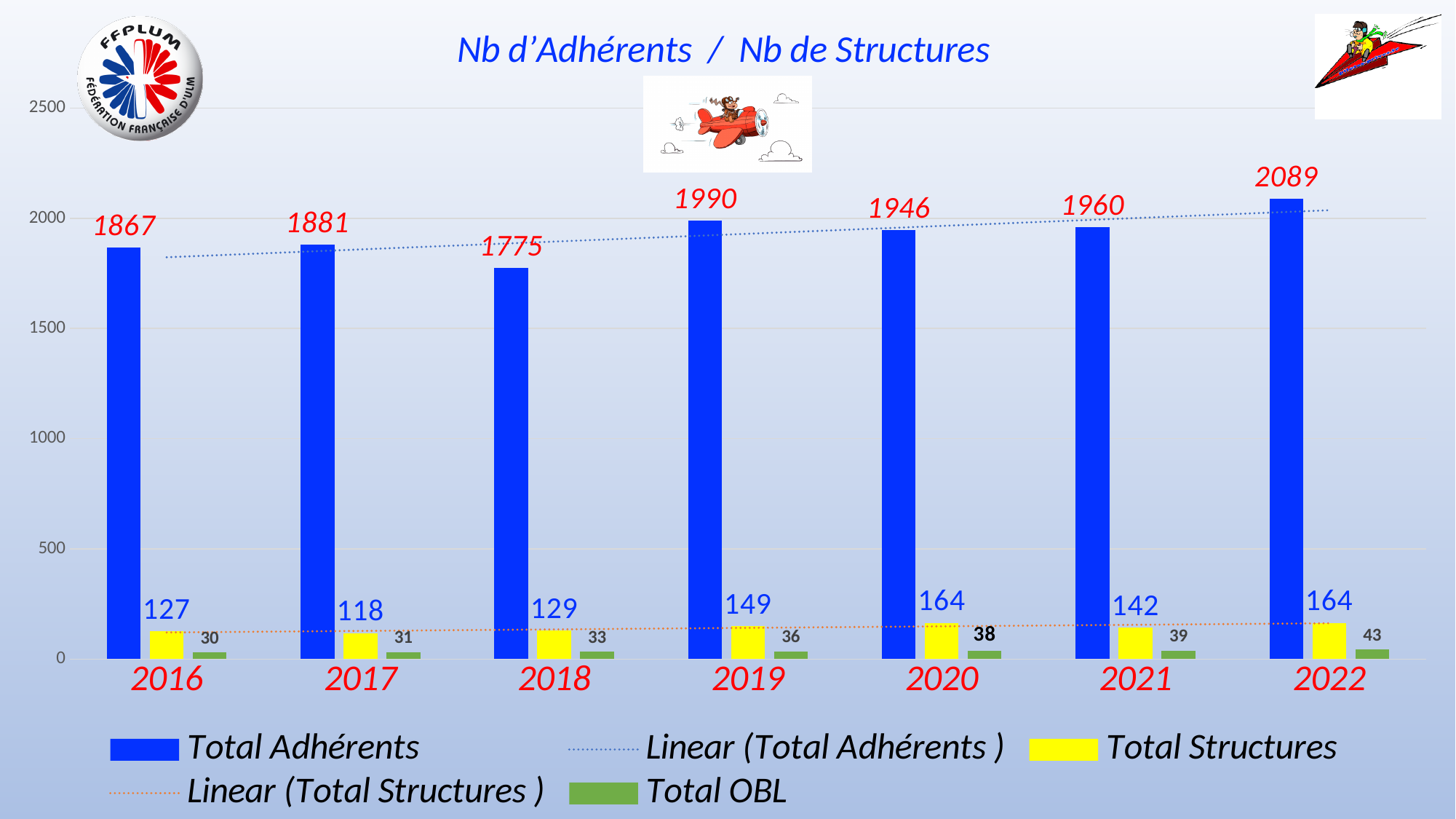
Do the Total OBL values rise or fall from 2016 to 2022? rise What is the difference between the Total Adhérents values for 2022 and 2016? 222 Which year has the lowest Total Structures value? 2017 Which is larger, the Total Adhérents value for 2020 or for 2021? 2021 Which year has the highest Total Adhérents value? 2022 What is the Total Adhérents value for 2019? 1990 What is the Total Structures value for 2017? 118 How many years are shown on the x axis? 7 Which year has the lowest Total Adhérents value? 2018 What is the Total OBL value for 2022? 43 What kind of chart is shown on the slide? bar chart How many entries does the legend list? 5